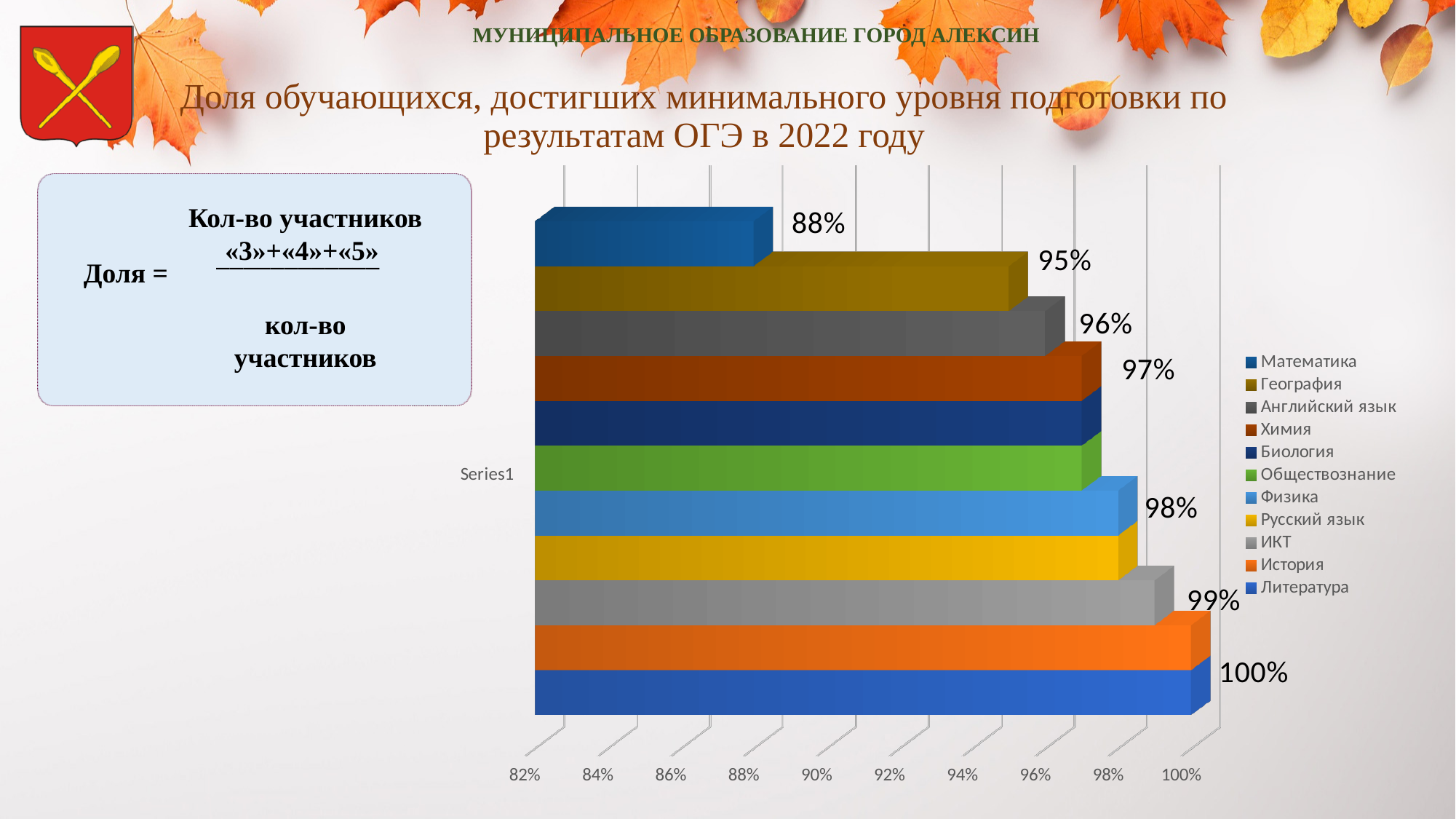
What kind of chart is shown on the slide? bar chart Which is larger, the value for География or the value for Английский язык? Английский язык Which subject has the lowest value on the chart? Математика What is the difference between the values for Литература and Математика? 12% What is the value shown for Английский язык? 96% Is the value for Биология greater or less than 90%? greater What is the value shown for Математика? 88% What is the value shown for География? 95% What is the value shown for Химия? 97% What is the value shown for Литература? 100% How many series does the legend list? 11